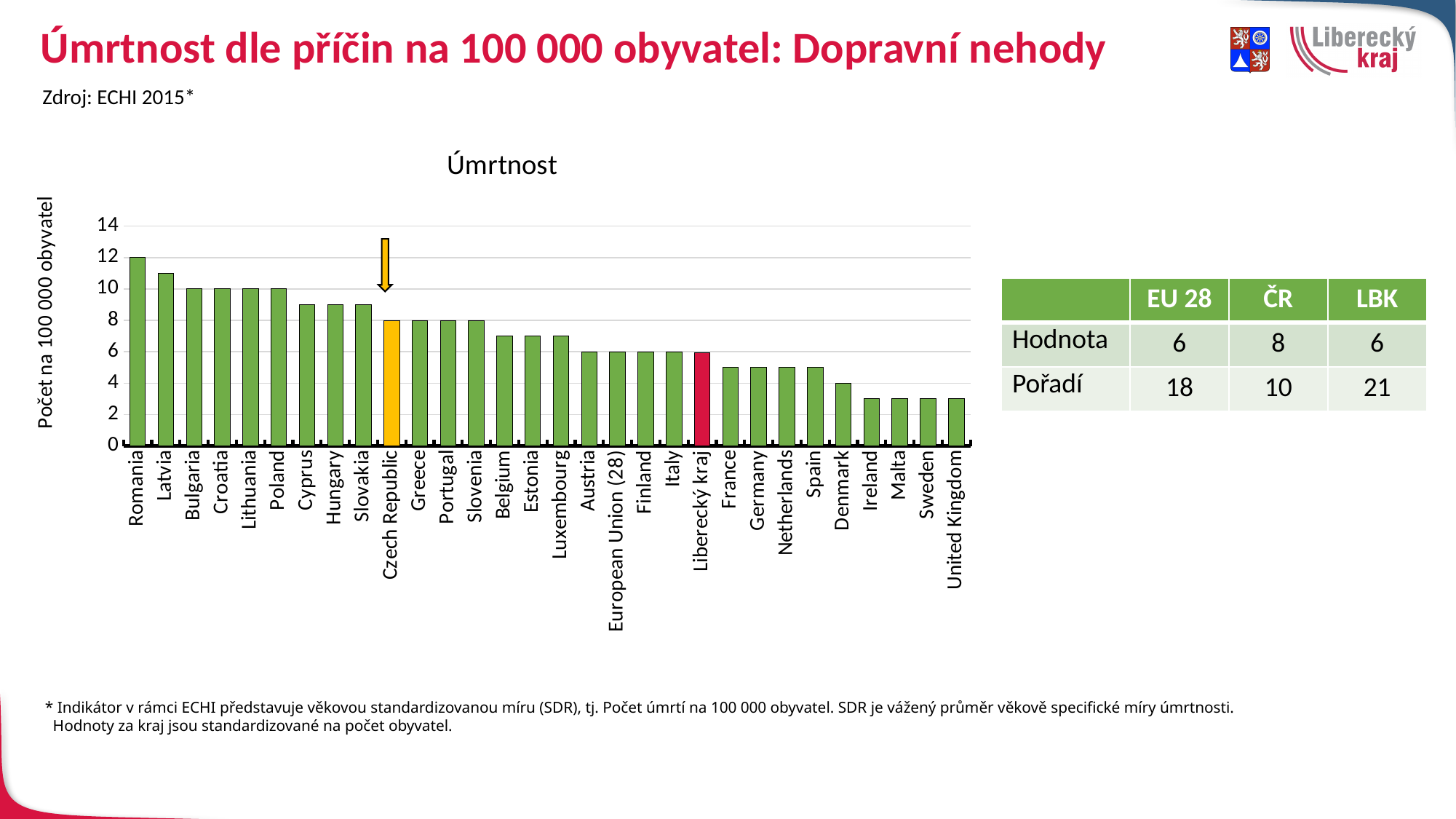
What is the difference between the values for Romania and Czech Republic? 4 What kind of chart is shown on the slide? bar chart What is the value for Liberecký kraj in the Úmrtnost chart? 6 Which country has the highest value in the Úmrtnost chart? Romania Is the value for Ireland greater or less than 4? less What is the value for Czech Republic in the Úmrtnost chart? 8 Which has a larger value, Bulgaria or Spain? Bulgaria How many countries or regions are shown in the Úmrtnost chart? 30 Do the values rise or fall from left to right along the x axis? fall What is the value for Romania in the Úmrtnost chart? 12 What is the value for Denmark in the Úmrtnost chart? 4 Is the value for Latvia greater or less than 10? greater